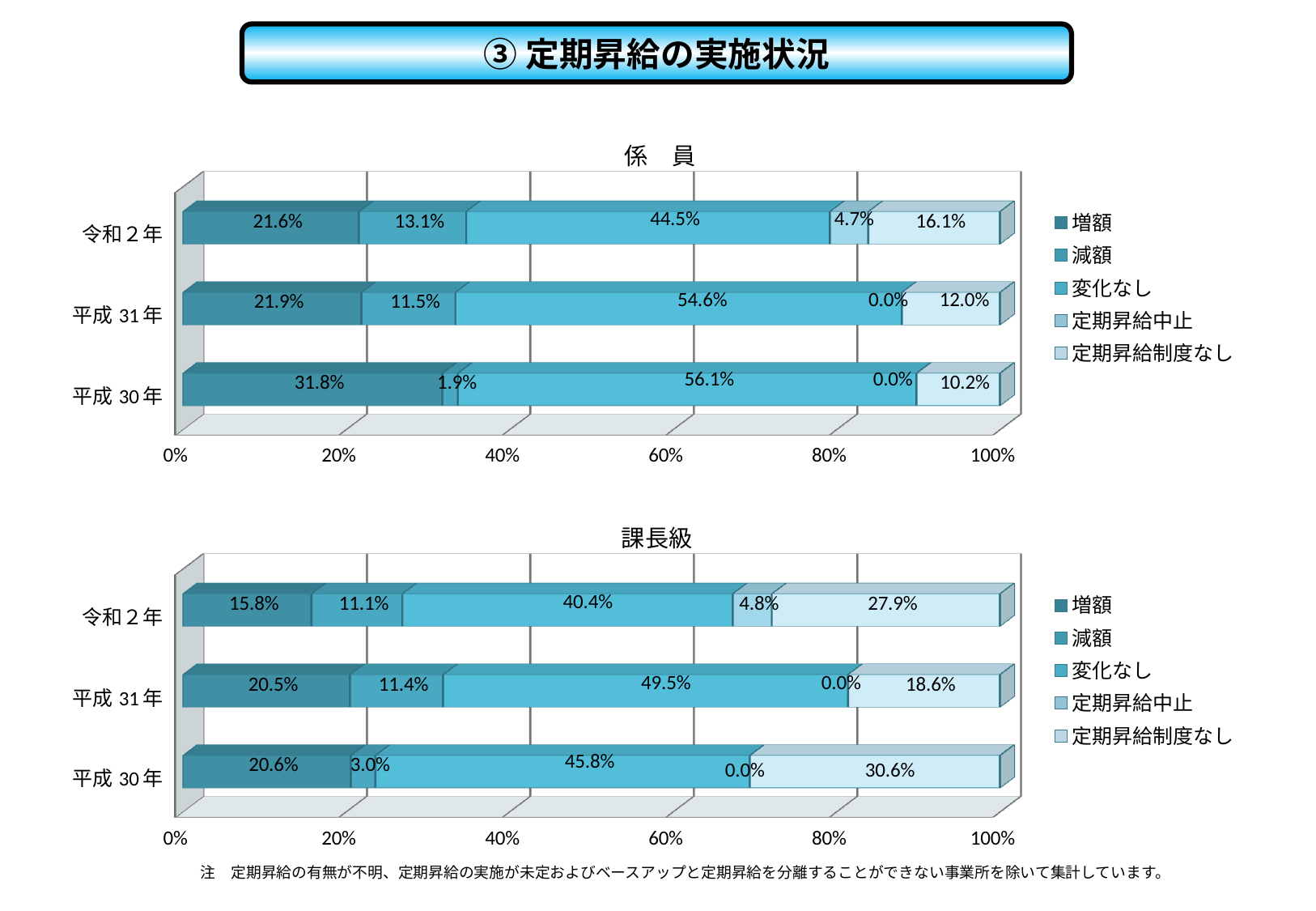
In the 係員 chart, what is the difference between the 増額 values for 平成30年 and 令和2年? 10.2% What kind of chart is the 課長級 chart? Stacked bar chart In the 課長級 chart, which is larger: 定期昇給制度なし in 令和2年 or in 平成31年? 令和2年 In the 係員 chart, what is the value for 増額 in 平成30年? 31.8% In the 課長級 chart, what is the value for 減額 in 令和2年? 11.1% How many years are shown in the 課長級 chart? 3 In the 課長級 chart, which year has the lowest value for 増額? 令和2年 In the 係員 chart, which year has the highest value for 変化なし? 平成30年 In the 係員 chart, what is the value for 変化なし in 令和2年? 44.5% In the 課長級 chart, what is the value for 定期昇給制度なし in 平成30年? 30.6% In the 課長級 chart, what is the value for 定期昇給中止 in 令和2年? 4.8% How many series does the legend of the 係員 chart list? 5